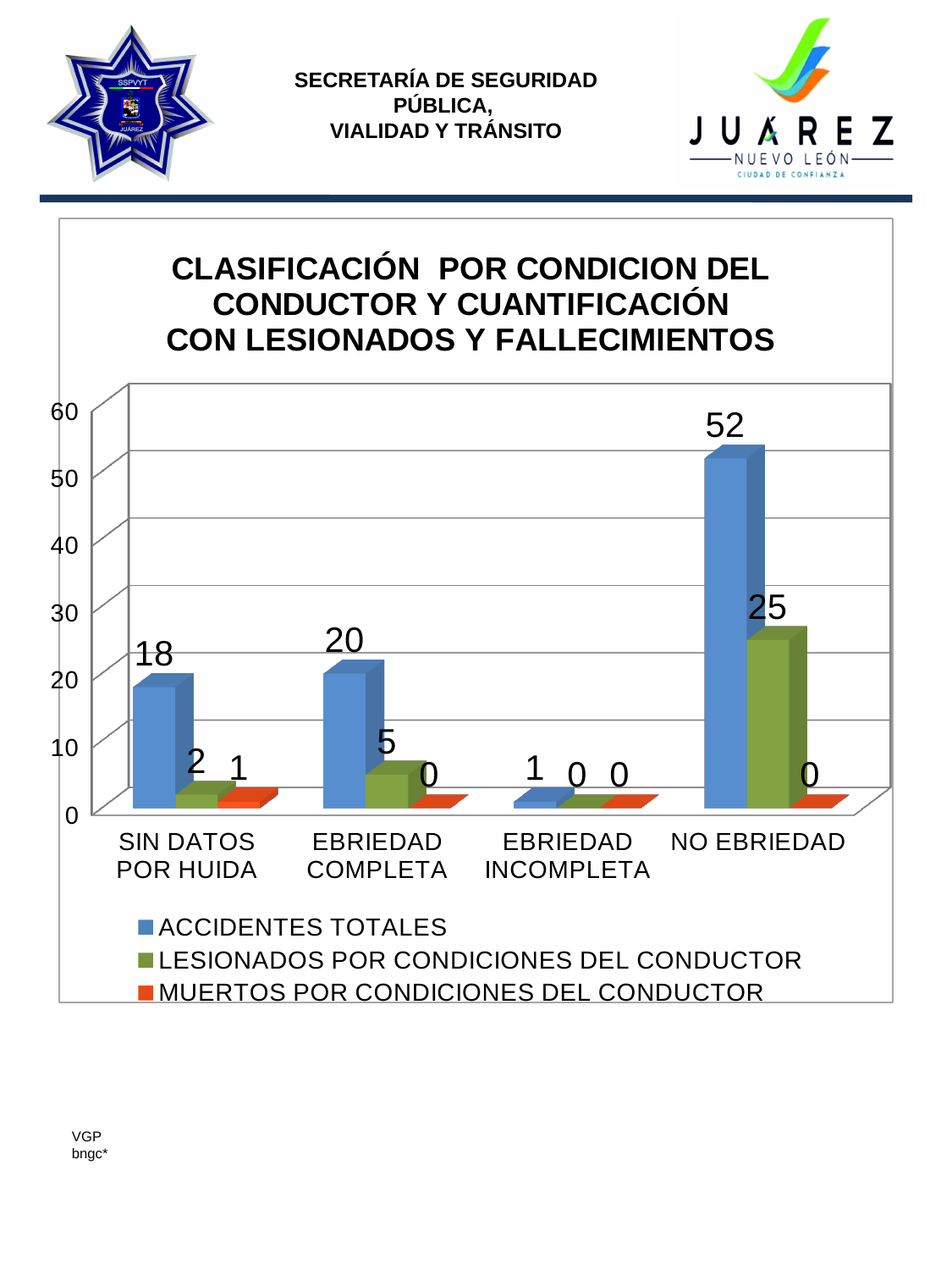
Which category has the lowest value for ACCIDENTES TOTALES? EBRIEDAD INCOMPLETA How many series does the legend list? 3 What kind of chart is shown on the slide? Bar chart What is the value of ACCIDENTES TOTALES for NO EBRIEDAD? 52 Which category has the highest value for ACCIDENTES TOTALES? NO EBRIEDAD What is the value of ACCIDENTES TOTALES for EBRIEDAD INCOMPLETA? 1 What is the value of LESIONADOS POR CONDICIONES DEL CONDUCTOR for EBRIEDAD COMPLETA? 5 What is the value of MUERTOS POR CONDICIONES DEL CONDUCTOR for SIN DATOS POR HUIDA? 1 Which is larger: ACCIDENTES TOTALES for SIN DATOS POR HUIDA or for EBRIEDAD COMPLETA? EBRIEDAD COMPLETA What is the difference between ACCIDENTES TOTALES for NO EBRIEDAD and for EBRIEDAD COMPLETA? 32 Which series is shown in orange in the legend? MUERTOS POR CONDICIONES DEL CONDUCTOR How many categories are shown on the x axis? 4